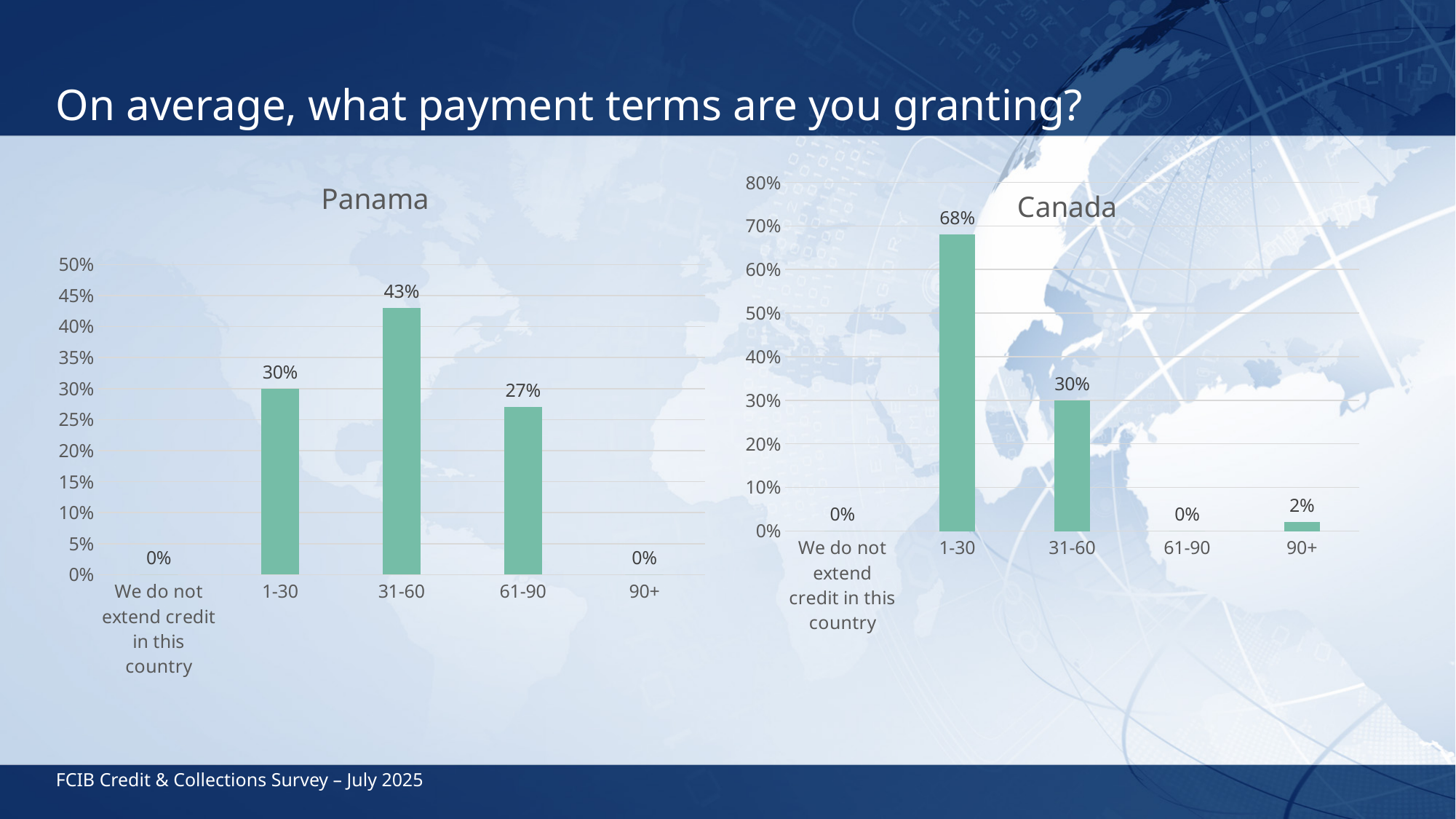
In the Canada chart, which category has the highest value? 1-30 In the Canada chart, what is the value for 90+? 2% In the Canada chart, what is the difference between the values for 1-30 and 31-60? 38% Which is larger: the value for 1-30 in the Panama chart or the value for 1-30 in the Canada chart? Canada In the Panama chart, what is the difference between the values for 31-60 and 1-30? 13% How many categories are shown on the x axis of the Panama chart? 5 What kind of chart is the Canada chart? Bar chart In the Panama chart, what is the value for 31-60? 43% What is the title of the chart on the left side of the slide? Panama In the Canada chart, what is the value for 1-30? 68% In the Panama chart, what is the value for 61-90? 27% In the Panama chart, which category has the highest value? 31-60